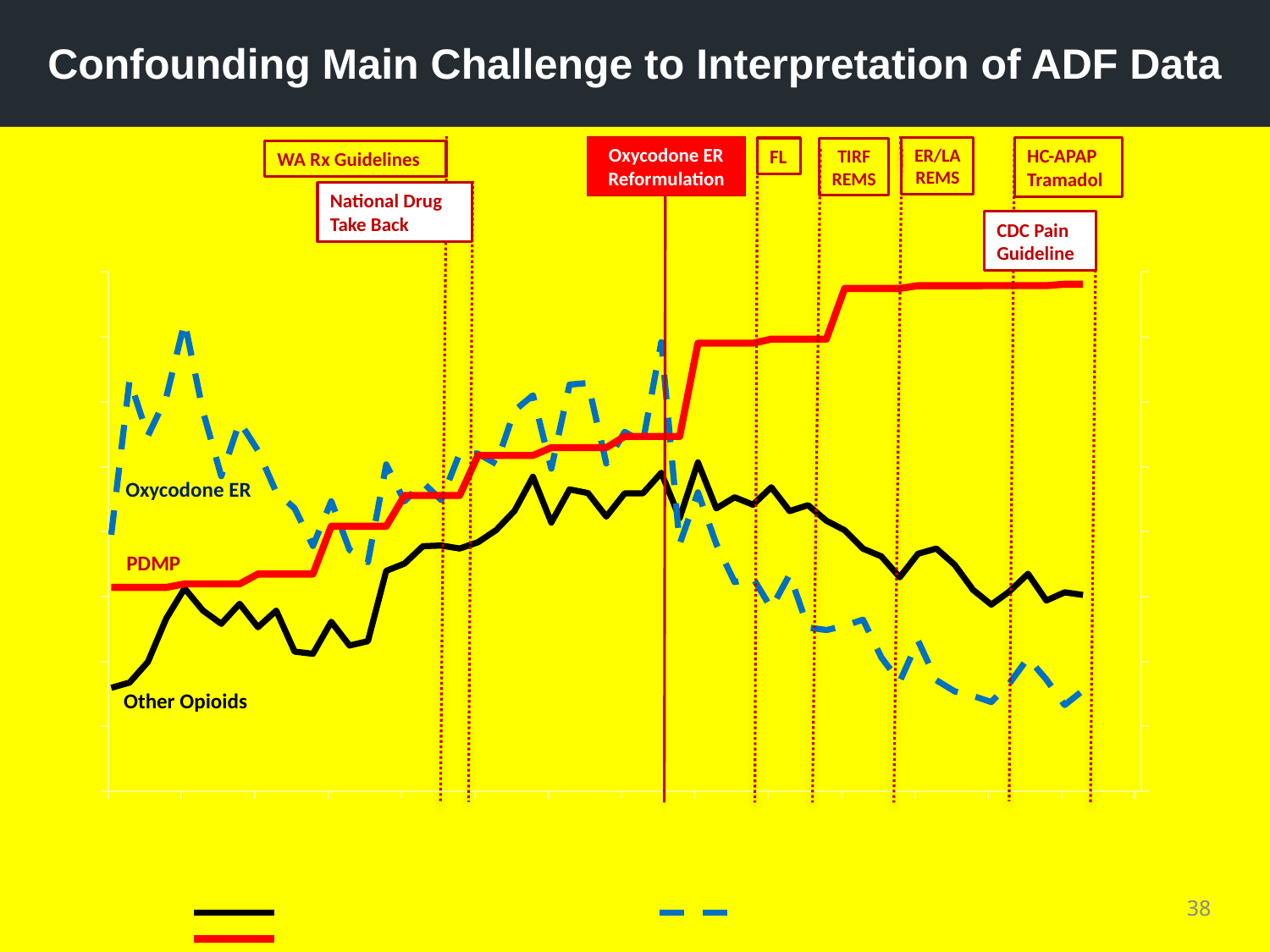
Which series is lowest at the left end of the chart? Other Opioids Does the Other Opioids series rise or fall over the last third of the chart? Fall Which series is highest at the right end of the chart? PDMP Which series is lowest at the right end of the chart? Oxycodone ER What kind of chart is shown on the slide? Line chart What is the title of the slide containing the chart? Confounding Main Challenge to Interpretation of ADF Data Does the PDMP series rise or fall along the x axis? Rise Which series is drawn as a dashed blue line? Oxycodone ER Which event is marked by the solid red vertical line in the middle of the chart? Oxycodone ER Reformulation At the right end of the chart, is the value for Other Opioids larger or smaller than the value for Oxycodone ER? Larger How many data series are plotted on the chart? 3 Does the Oxycodone ER series rise or fall after the Oxycodone ER Reformulation line? Fall